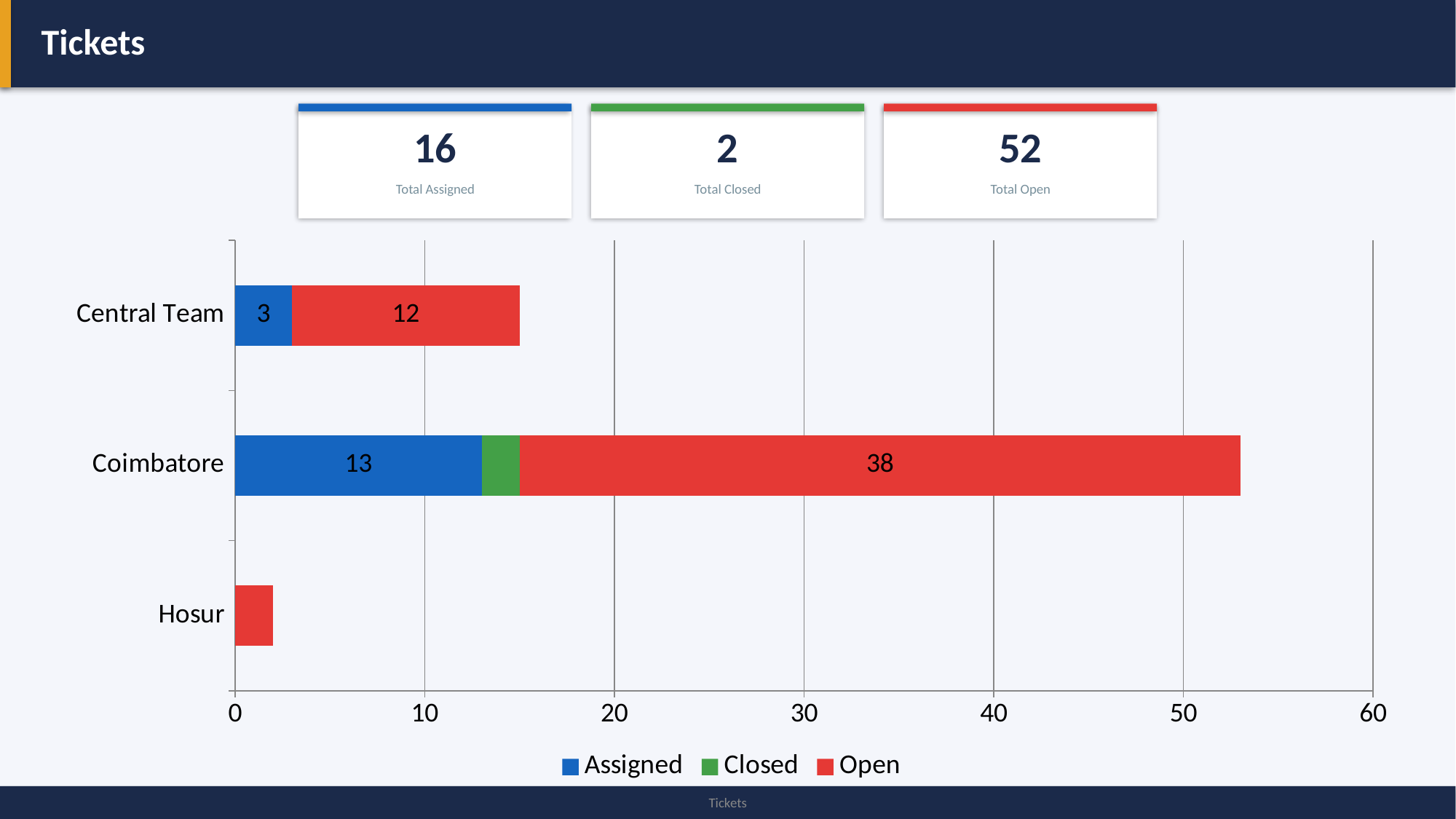
Is the total value for Hosur greater or less than 10? less How many categories are shown on the chart? 3 What is the Open value for Central Team? 12 Which category has the longest total bar? Coimbatore What is the Assigned value for Central Team? 3 Which has a larger Assigned value, Coimbatore or Central Team? Coimbatore What is the Open value for Coimbatore? 38 What kind of chart is shown on the slide? stacked bar chart What is the Assigned value for Coimbatore? 13 How many series does the legend list? 3 What is the difference between the Open value for Coimbatore and the Open value for Central Team? 26 Which category has the shortest total bar? Hosur